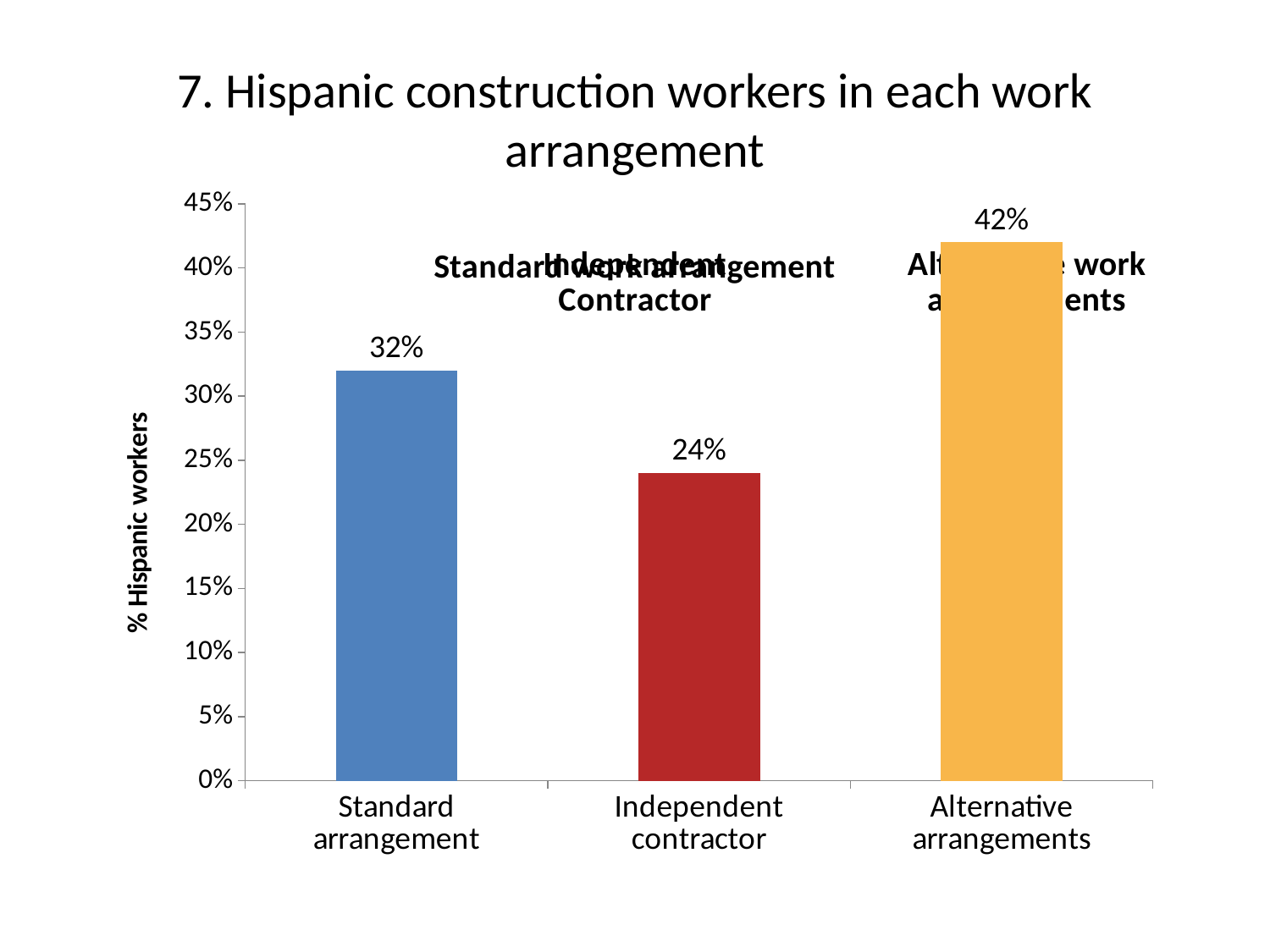
Which is larger, the value for Standard arrangement or the value for Independent contractor? Standard arrangement What is the difference between the values for Standard arrangement and Independent contractor? 8% What is the value for Alternative arrangements? 42% Is the value for Alternative arrangements greater or less than 40%? greater What is the value for Independent contractor? 24% What is the label of the vertical axis? % Hispanic workers What kind of chart is shown on the slide? Bar chart Which work arrangement has the lowest percentage of Hispanic workers? Independent contractor Which work arrangement has the highest percentage of Hispanic workers? Alternative arrangements What is the value for Standard arrangement? 32% How many categories are shown on the x axis? 3 What is the difference between the values for Alternative arrangements and Standard arrangement? 10%